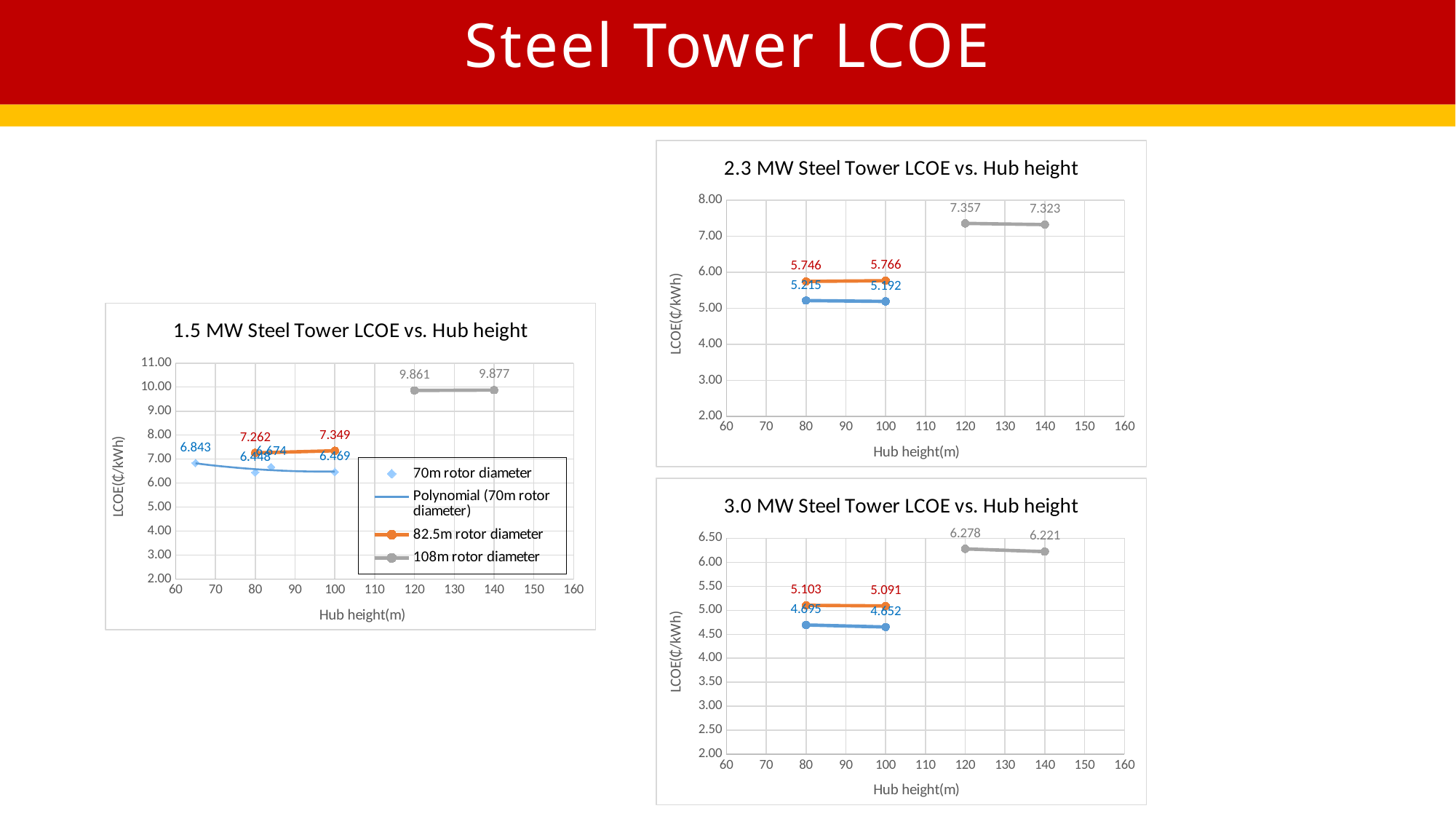
In the 2.3 MW Steel Tower LCOE vs. Hub height chart, what is the difference between the two labelled values on the orange series (5.766 and 5.746)? 0.020 How many entries does the legend list in the 1.5 MW Steel Tower LCOE vs. Hub height chart? 4 In the 2.3 MW Steel Tower LCOE vs. Hub height chart, is the gray series value at 140 m greater or less than 7.00? greater In the 3.0 MW Steel Tower LCOE vs. Hub height chart, what is the LCOE value labelled at a hub height of 140 m on the gray series? 6.221 What is the y-axis label on the 2.3 MW Steel Tower LCOE vs. Hub height chart? LCOE(₵/kWh) In the 2.3 MW Steel Tower LCOE vs. Hub height chart, what is the LCOE value labelled at a hub height of 120 m on the gray series? 7.357 In the 3.0 MW Steel Tower LCOE vs. Hub height chart, does the blue series rise or fall as hub height increases from 80 m to 100 m? Fall What kind of chart is the 3.0 MW Steel Tower LCOE vs. Hub height chart? Line chart In the 1.5 MW Steel Tower LCOE vs. Hub height chart, what is the highest LCOE value labelled on the chart? 9.877 In the 3.0 MW Steel Tower LCOE vs. Hub height chart, what is the lowest LCOE value labelled on the chart? 4.652 In the 1.5 MW Steel Tower LCOE vs. Hub height chart, what is the LCOE value labelled for the 82.5m rotor diameter at a hub height of 100 m? 7.349 In the 3.0 MW Steel Tower LCOE vs. Hub height chart, which is larger: the gray series value at 120 m or at 140 m? 120 m (6.278)